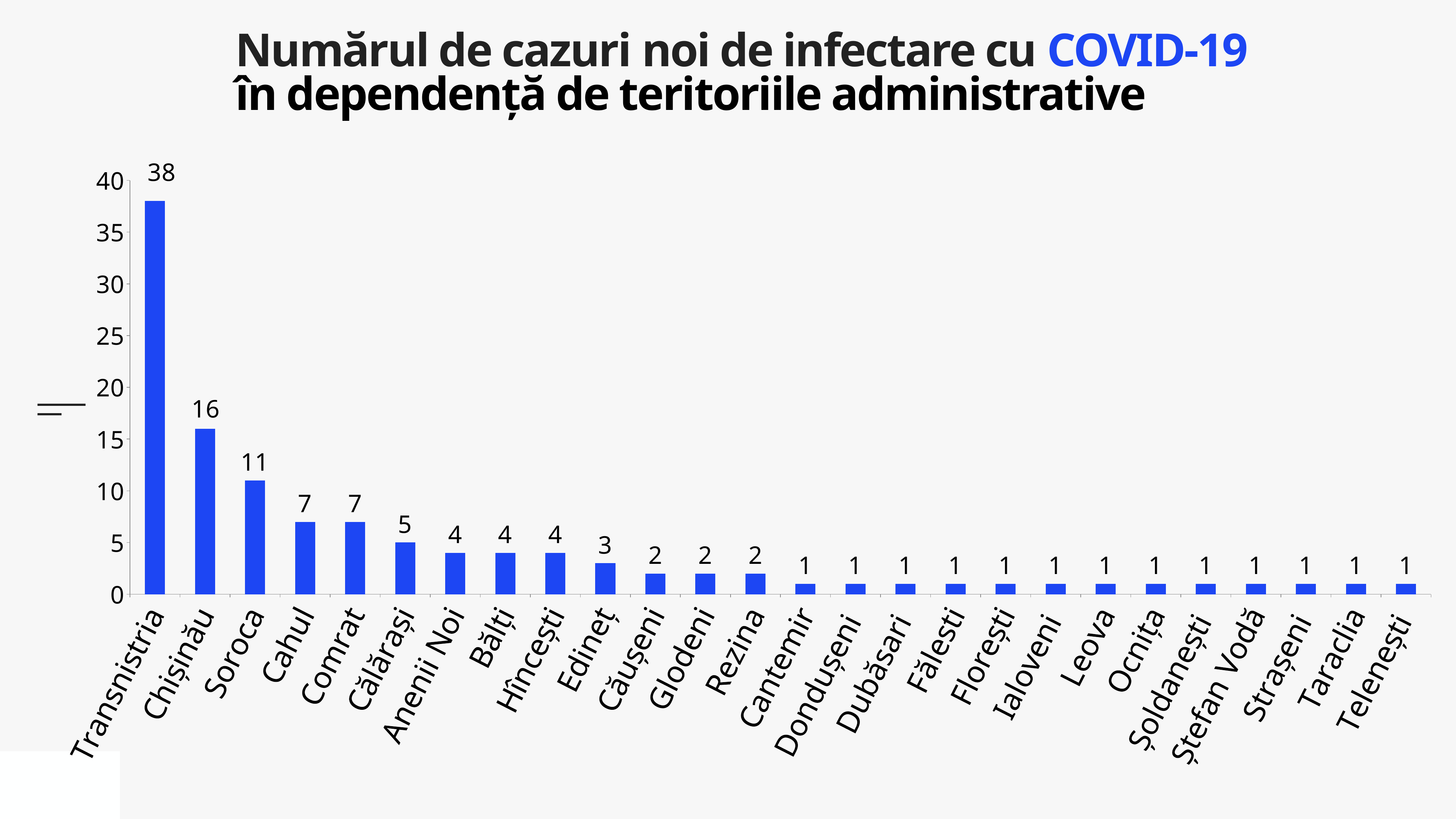
What is the value for Soroca? 11 What is the value for Edineț? 3 What is the value for Chișinău? 16 Is the value for Chișinău greater or less than 20? less Which is larger, the value for Călărași or the value for Rezina? Călărași How many territories are shown on the x axis? 26 Which territory has the highest number of new cases? Transnistria What is the difference between the values for Transnistria and Chișinău? 22 What kind of chart is shown on the slide? bar chart Do the values rise or fall from left to right along the x axis? fall What is the value for Transnistria? 38 What is the difference between the values for Soroca and Cahul? 4